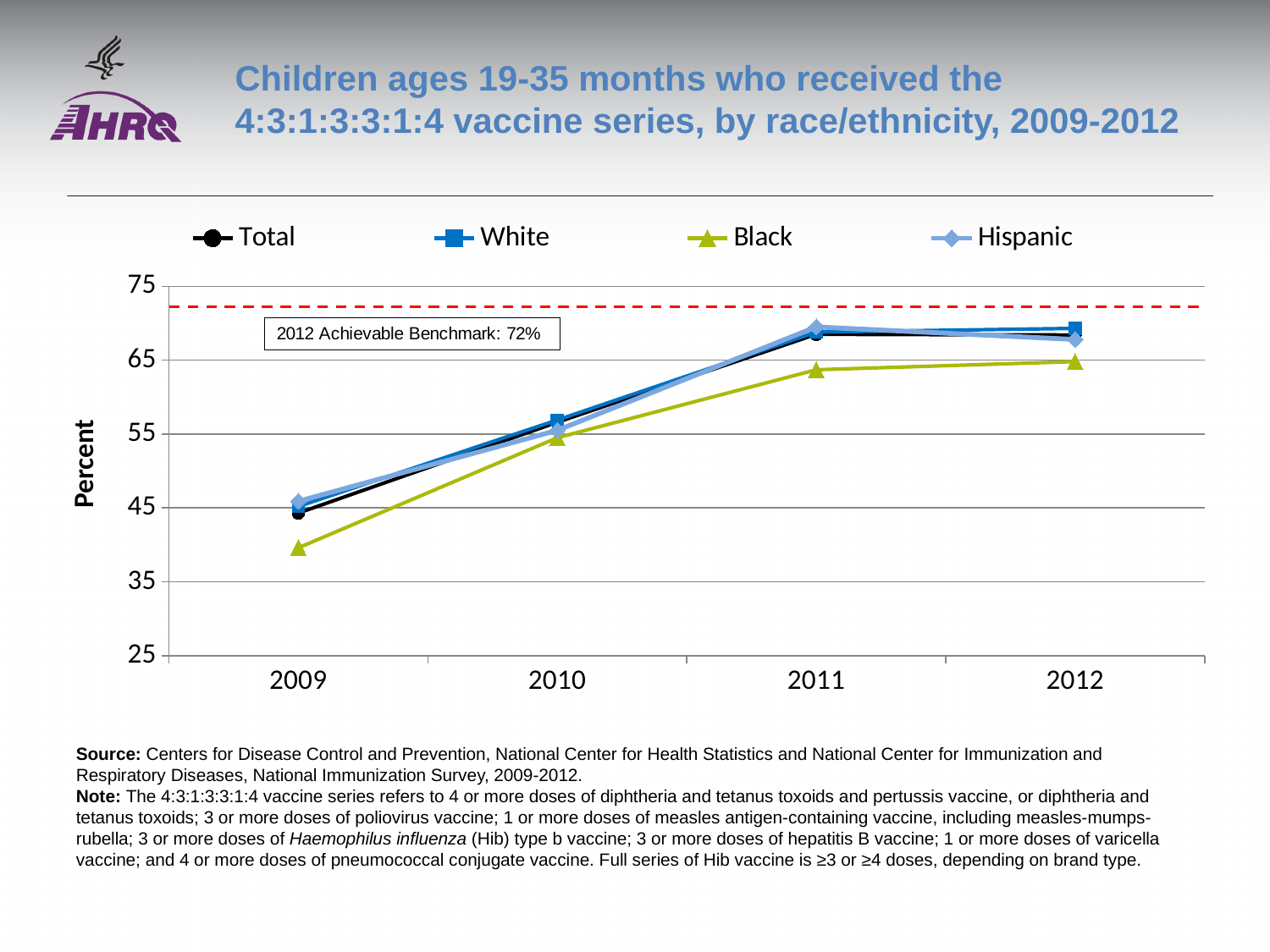
What is the 2012 Achievable Benchmark shown on the chart? 72% What kind of chart is shown on the slide? line chart Is the value for White in 2012 greater or less than 65? greater Which race/ethnicity group has the lowest value in 2009? Black Which group has the lowest value in 2012? Black Is the value for Black in 2011 greater or less than 65? less In 2011, which is larger, the value for White or the value for Black? White Is the value for Black in 2009 greater or less than 45? less How many series does the legend list? 4 How many years are plotted along the x axis? 4 Does the value for Black rise or fall from 2009 to 2012? rise